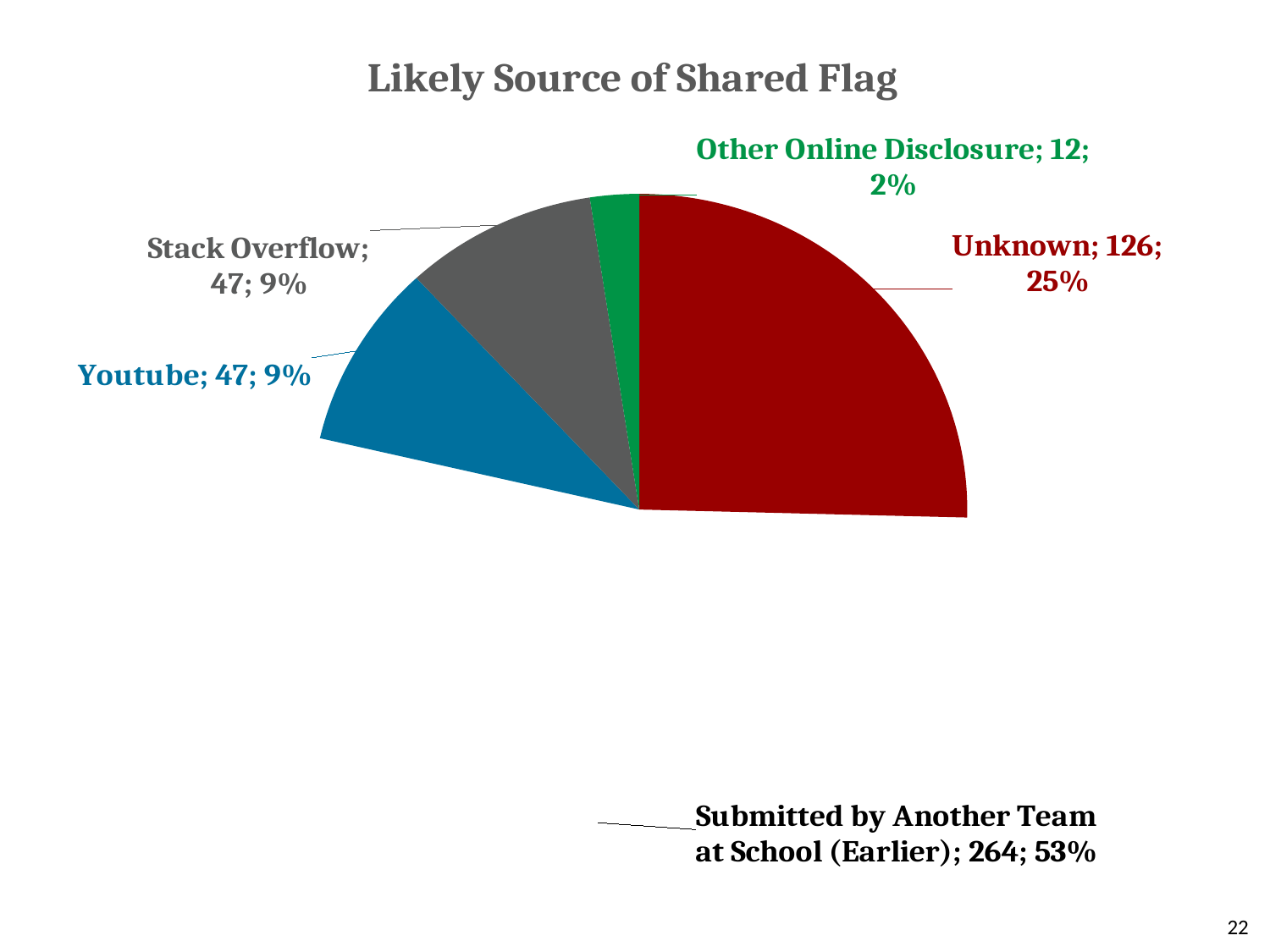
What is the title of the chart? Likely Source of Shared Flag What colour is the Unknown slice? dark red What percentage share does Unknown have? 25% What is the count for Unknown? 126 Which is larger, the count for Unknown or the count for Stack Overflow? Unknown How many categories are labelled in the pie chart? 5 What percentage share does Submitted by Another Team at School (Earlier) have? 53% What kind of chart is shown on the slide? pie chart What is the difference between the counts for Unknown and Youtube? 79 Which category has the smallest share of the pie? Other Online Disclosure Which category has the largest share of the pie? Submitted by Another Team at School (Earlier) What is the count for Other Online Disclosure? 12